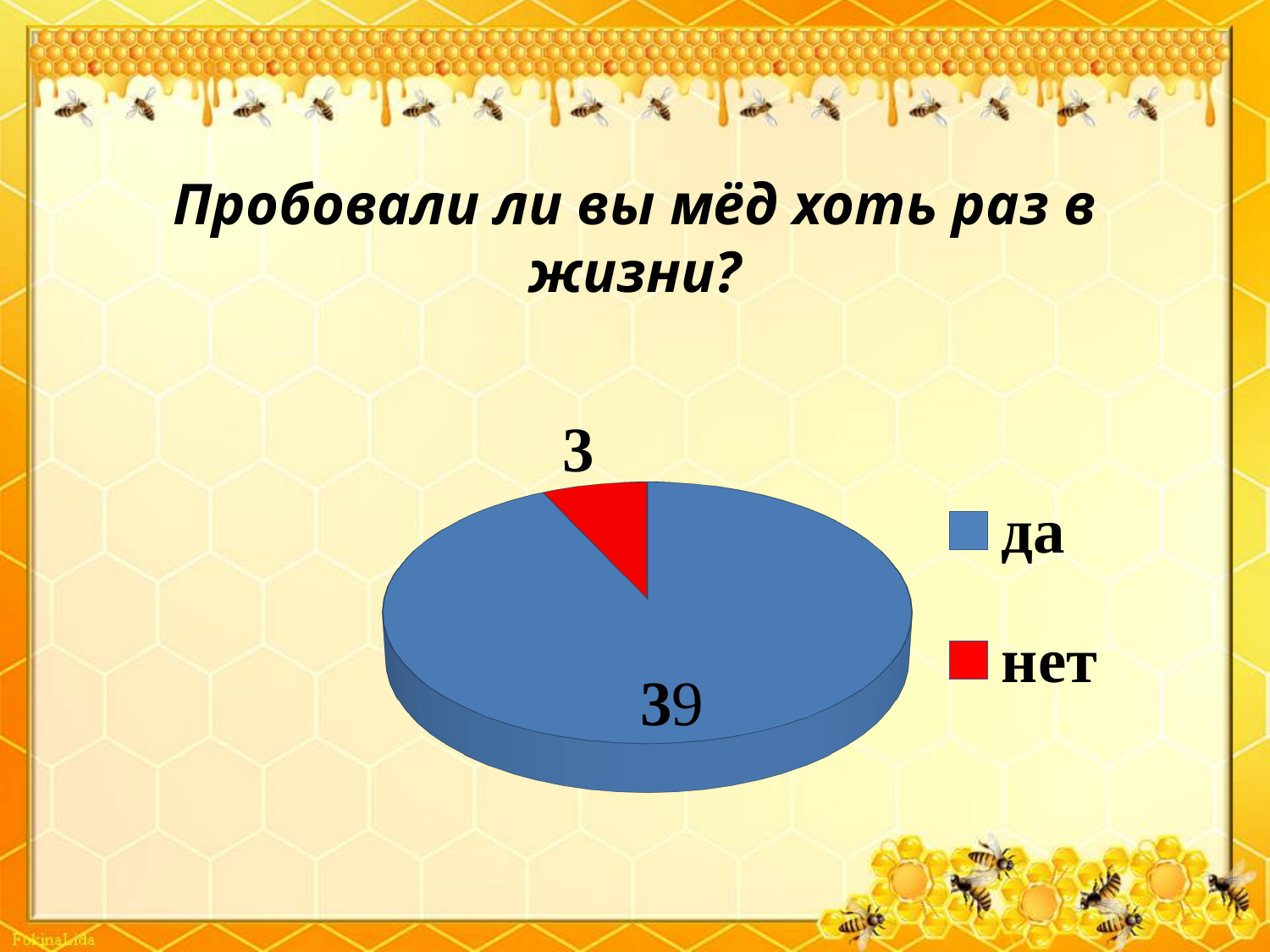
What is the value for "да"? 39 Which is larger, the value for "да" or the value for "нет"? да Which category has the smallest slice? нет What kind of chart is shown on the slide? pie chart What is the value for "нет"? 3 What colour is the slice for "нет"? red What is the total of all slices in the pie chart? 42 How many categories does the pie chart have? 2 Which category has the largest slice? да What is the difference between the values for "да" and "нет"? 36 What is the title of the slide above the chart? Пробовали ли вы мёд хоть раз в жизни?